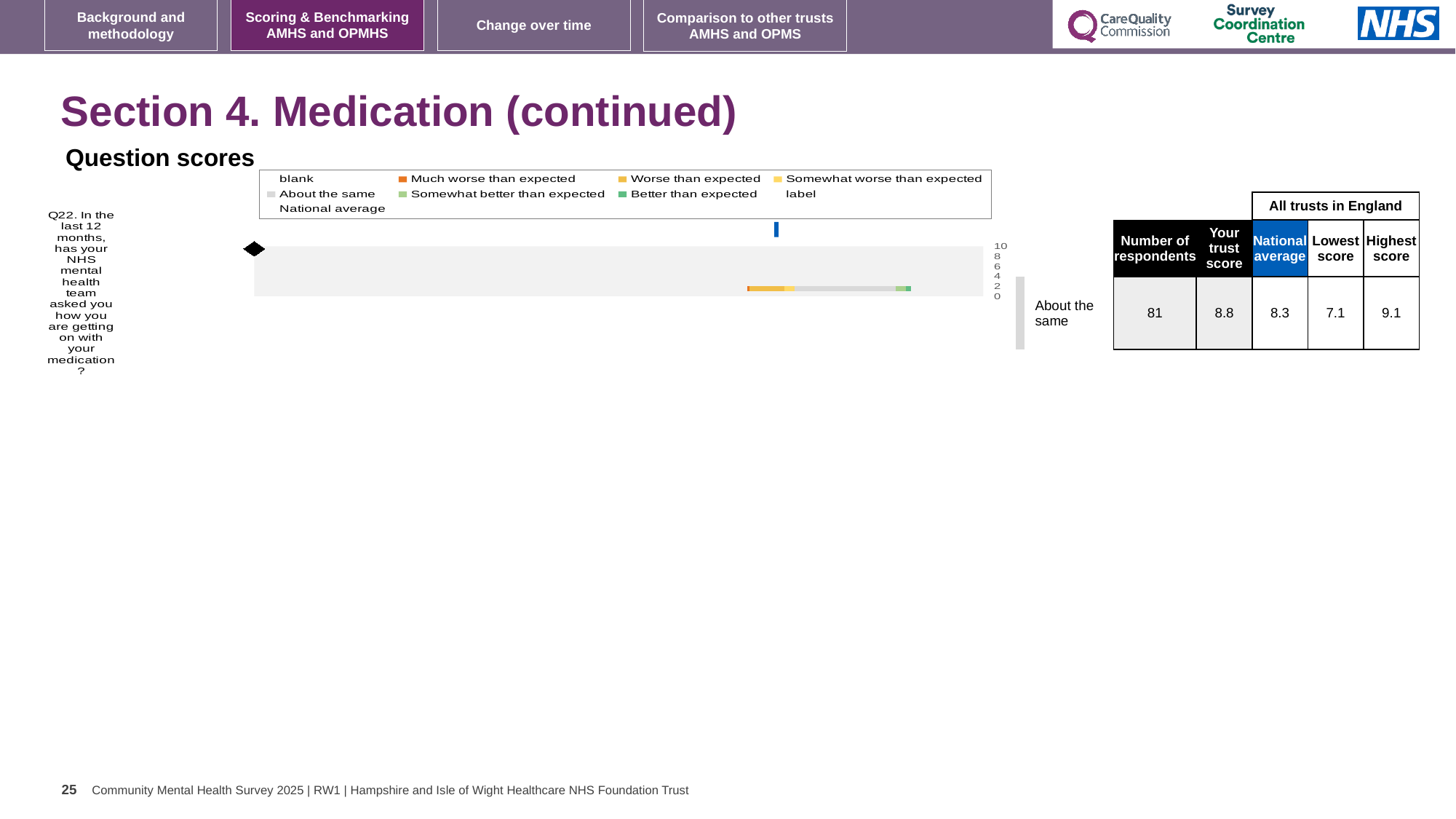
What is the difference between the highest score (9.1) and the lowest score (7.1) for Q22? 2.0 How many questions (categories) are plotted in the question scores chart? 1 What is the trust's score for Q22 shown alongside the chart? 8.8 Which legend entry in the chart is shown in orange? Much worse than expected Which benchmark category is shown for Q22 next to the chart? About the same What is the highest tick value shown on the chart's score axis? 10 Which is larger for Q22, the trust score or the national average? trust score What is the heading above the chart? Question scores What kind of chart is used to show the Q22 question score? bar chart How many respondents answered Q22? 81 What is the national average score for Q22 shown alongside the chart? 8.3 Which question number is plotted in the question scores chart? Q22